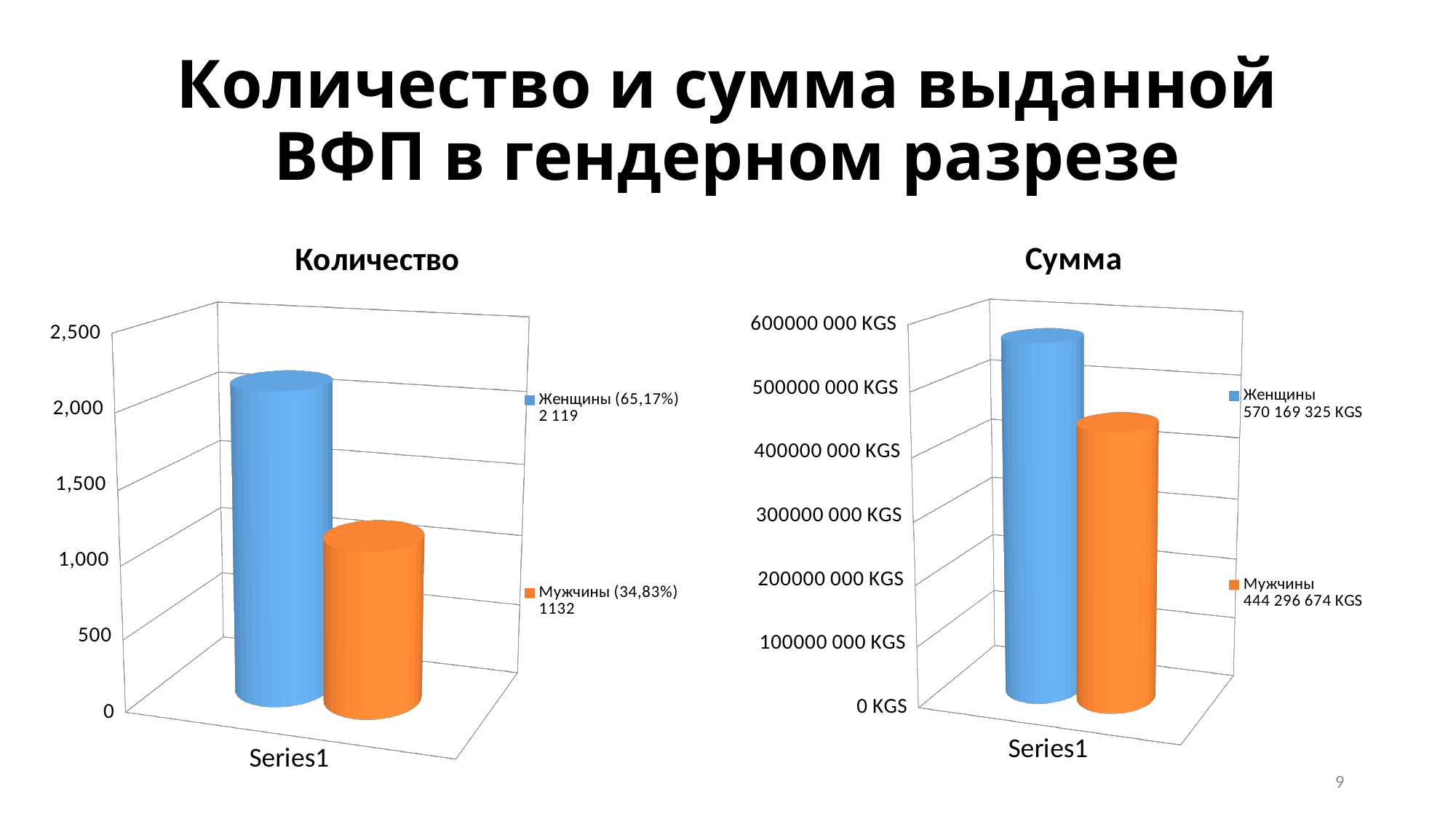
How many series does the legend of the "Сумма" chart list? 2 In the "Сумма" chart, which group has the lower value? Мужчины In the "Количество" chart, what percentage share is shown in the legend for Мужчины? 34,83% In the "Сумма" chart, what is the difference between the values for Женщины and Мужчины? 125 872 651 KGS In the "Количество" chart, which group has the higher value? Женщины In the "Количество" chart, what is the value for Мужчины? 1132 In the "Сумма" chart, what is the value for Мужчины? 444 296 674 KGS In the "Количество" chart, what is the value for Женщины? 2 119 In the "Количество" chart, what is the difference between the values for Женщины and Мужчины? 987 In the "Сумма" chart, is the value for Мужчины greater or less than 400000 000 KGS? greater What kind of chart is the "Количество" chart? bar chart In the "Сумма" chart, what is the value for Женщины? 570 169 325 KGS